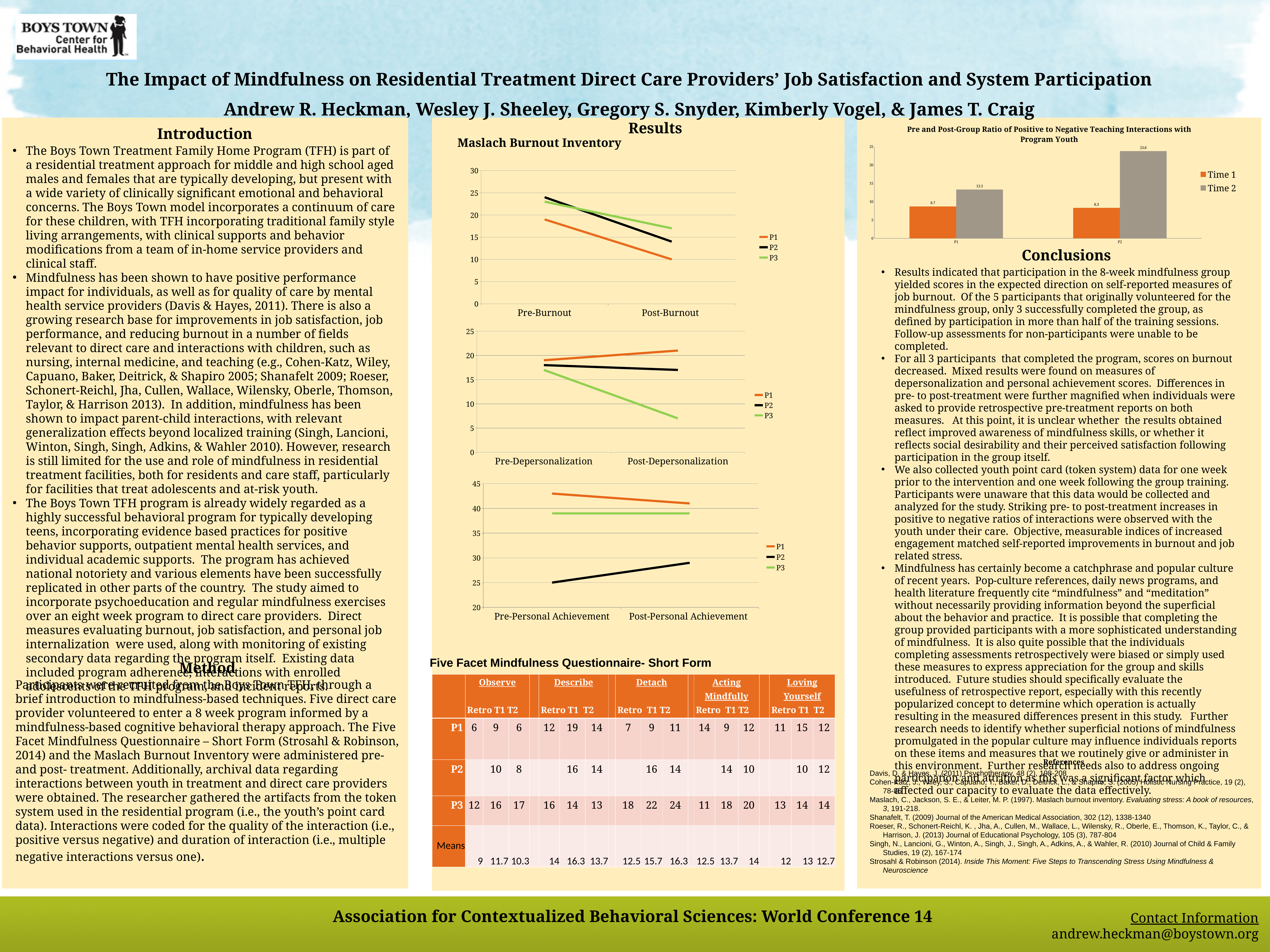
In the Maslach Burnout Inventory chart with Pre-Burnout and Post-Burnout on the x axis, does the value for P1 rise or fall from Pre-Burnout to Post-Burnout? fall In the Maslach Burnout Inventory chart with Pre-Burnout and Post-Burnout on the x axis, is the Post-Burnout value for P1 greater or less than 15? less In the bar chart titled 'Pre and Post-Group Ratio of Positive to Negative Teaching Interactions with Program Youth', what is the difference between the Time 2 and Time 1 values for P2? 15.5 What kind of chart is the Maslach Burnout Inventory chart with Pre-Burnout and Post-Burnout on the x axis? line chart In the bar chart titled 'Pre and Post-Group Ratio of Positive to Negative Teaching Interactions with Program Youth', what is the Time 2 value for P2? 23.8 In the bar chart titled 'Pre and Post-Group Ratio of Positive to Negative Teaching Interactions with Program Youth', what is the Time 1 value for P1? 8.7 In the chart with Pre-Personal Achievement and Post-Personal Achievement on the x axis, is the Pre-Personal Achievement value for P2 greater or less than 30? less In the bar chart titled 'Pre and Post-Group Ratio of Positive to Negative Teaching Interactions with Program Youth', which is larger: the Time 2 value for P1 or the Time 2 value for P2? P2 In the bar chart titled 'Pre and Post-Group Ratio of Positive to Negative Teaching Interactions with Program Youth', which bar is the highest? P2 Time 2 In the bar chart titled 'Pre and Post-Group Ratio of Positive to Negative Teaching Interactions with Program Youth', how many series does the legend list? 2 In the chart with Pre-Depersonalization and Post-Depersonalization on the x axis, is the Post-Depersonalization value for P3 greater or less than 10? less What kind of chart is the 'Pre and Post-Group Ratio of Positive to Negative Teaching Interactions with Program Youth' chart? bar chart